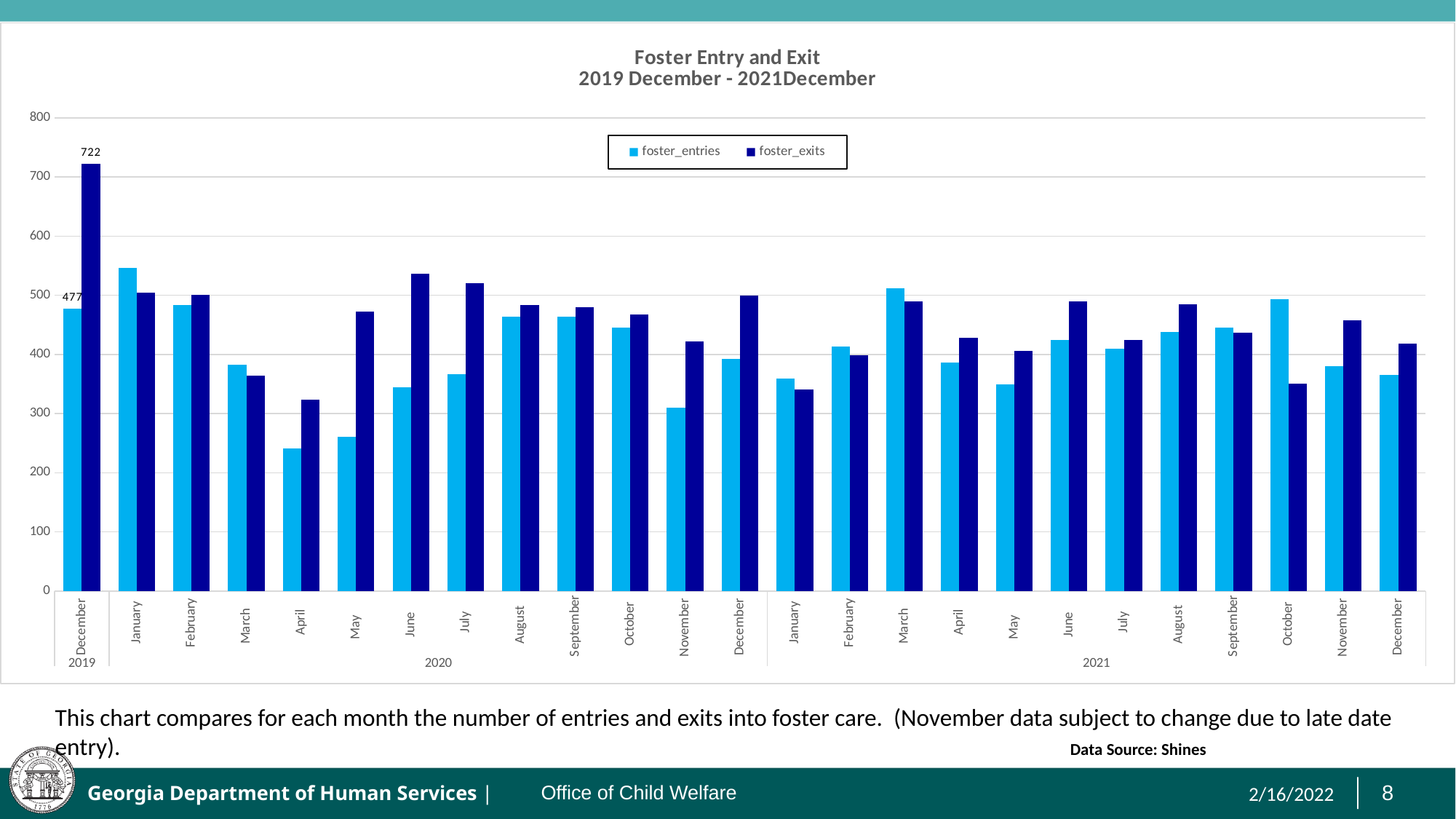
What is the value of foster_entries for December 2019? 477 Which month has the lowest foster_entries value? April 2020 How many series does the legend list? 2 What is the value of foster_exits for December 2019? 722 In October 2021, which is larger: foster_entries or foster_exits? foster_entries Is the value of foster_entries for November 2020 greater or less than 400? less What type of chart is shown on the slide? Bar chart How many months are shown on the x axis? 25 Is the value of foster_entries for January 2020 greater or less than 500? greater What is the difference between foster_exits and foster_entries in December 2019? 245 Which month has the highest foster_exits value? December 2019 In April 2020, which is larger: foster_entries or foster_exits? foster_exits